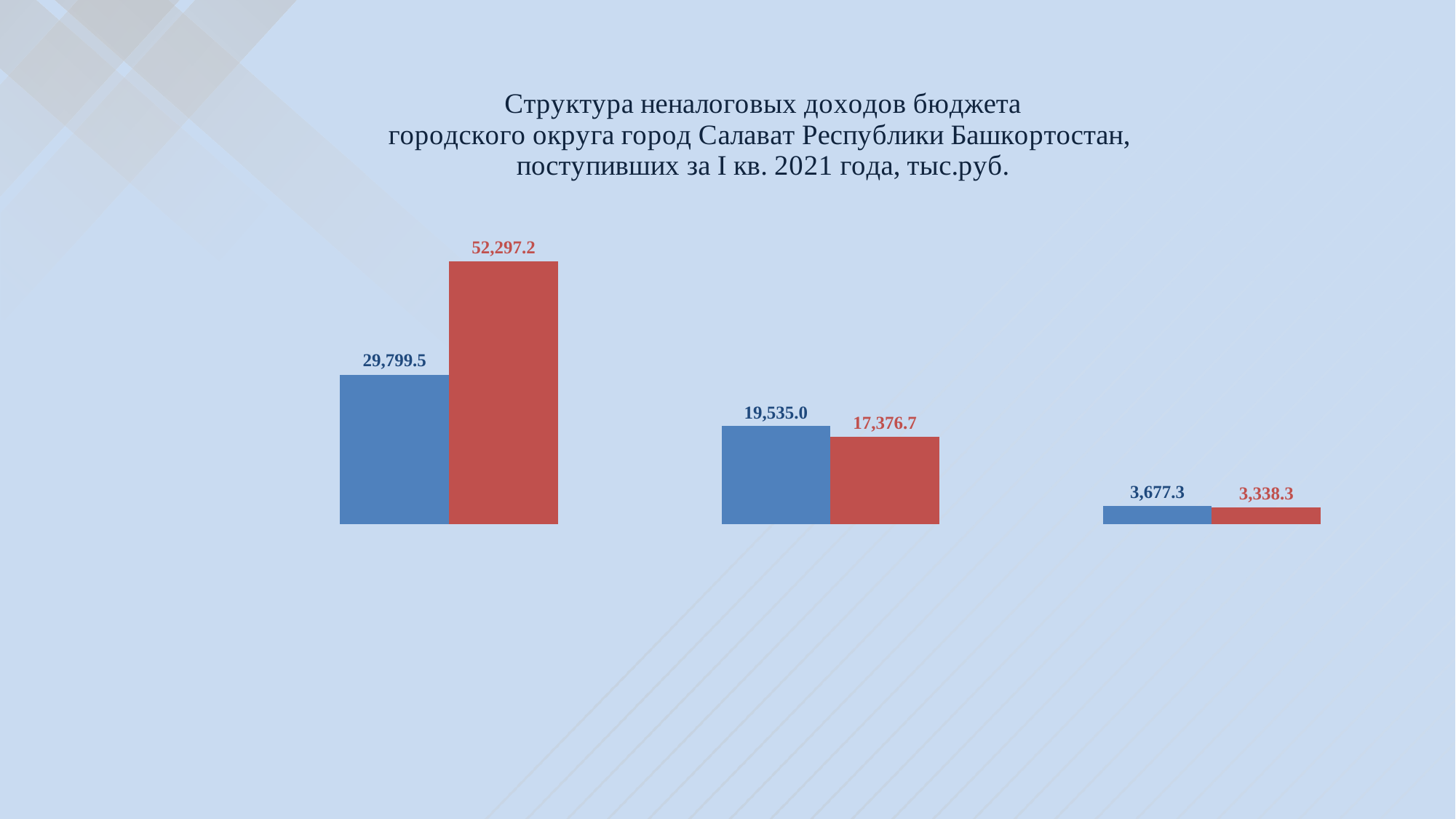
What is the value of the red bar in the leftmost group? 52,297.2 How many groups of bars are shown on the chart? 3 What is the difference between the blue and red bars in the middle group? 2,158.3 What type of chart is shown on the slide? bar chart How many bars are there in each group? 2 What is the difference between the red and blue bars in the leftmost group? 22,497.7 What is the value of the blue bar in the middle group? 19,535.0 In the middle group, which bar is larger, the blue one or the red one? blue What is the value of the red bar in the rightmost group? 3,338.3 What is the value of the blue bar in the leftmost group? 29,799.5 What is the highest value shown on the chart? 52,297.2 What is the lowest value shown on the chart? 3,338.3